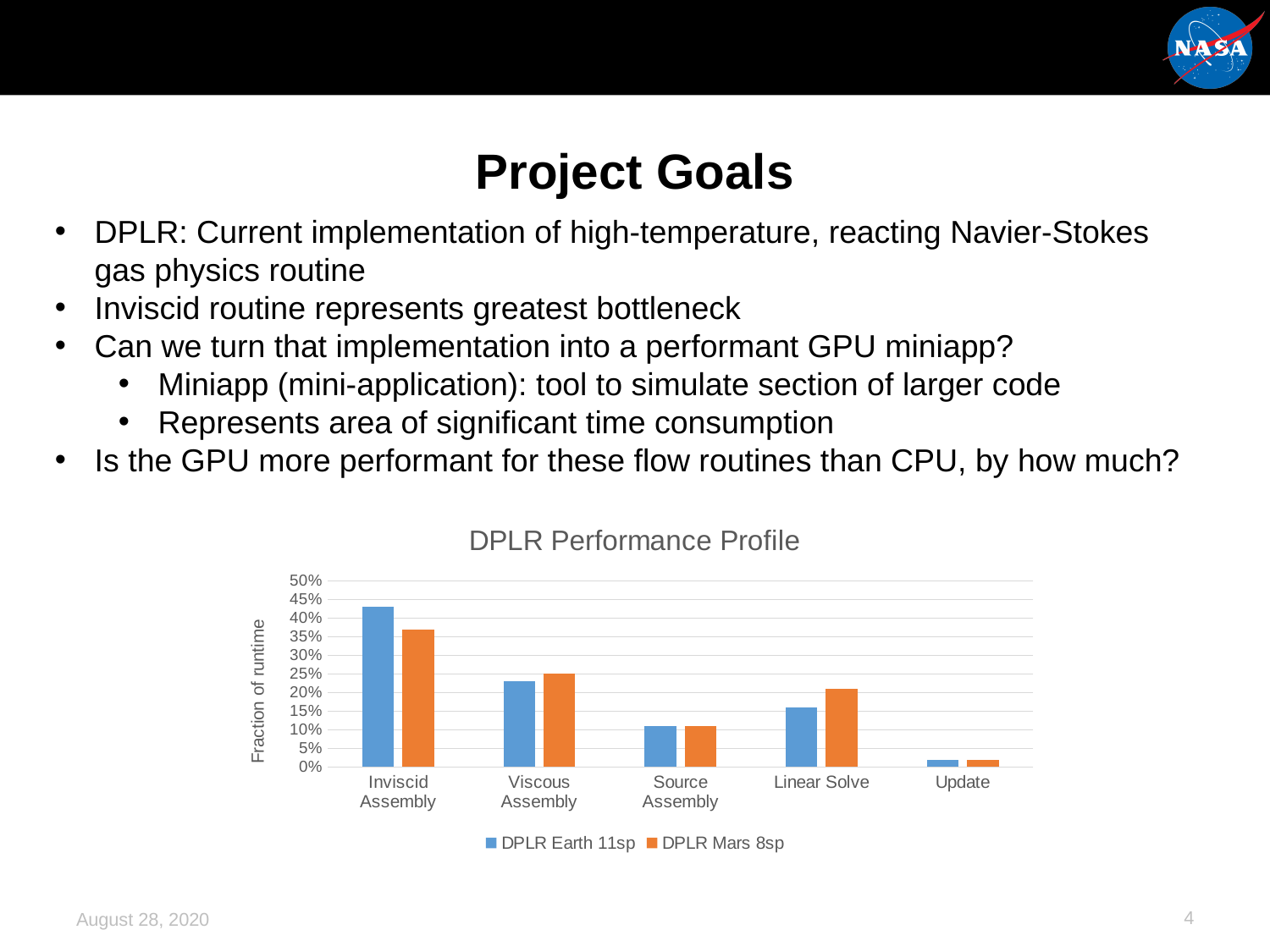
Is the DPLR Earth 11sp value for Linear Solve greater or less than 20%? less What is the label of the y axis on the DPLR Performance Profile chart? Fraction of runtime Which category has the lowest fraction of runtime for DPLR Mars 8sp? Update What type of chart is the DPLR Performance Profile? bar chart Which category has the highest fraction of runtime for DPLR Earth 11sp? Inviscid Assembly For Inviscid Assembly, which series has the larger fraction of runtime, DPLR Earth 11sp or DPLR Mars 8sp? DPLR Earth 11sp Is the DPLR Mars 8sp value for Inviscid Assembly greater or less than 40%? less Is the DPLR Earth 11sp value for Inviscid Assembly greater or less than 40%? greater For Linear Solve, which series has the larger fraction of runtime, DPLR Earth 11sp or DPLR Mars 8sp? DPLR Mars 8sp How many series does the legend of the DPLR Performance Profile chart list? 2 How many categories are shown on the x axis of the DPLR Performance Profile chart? 5